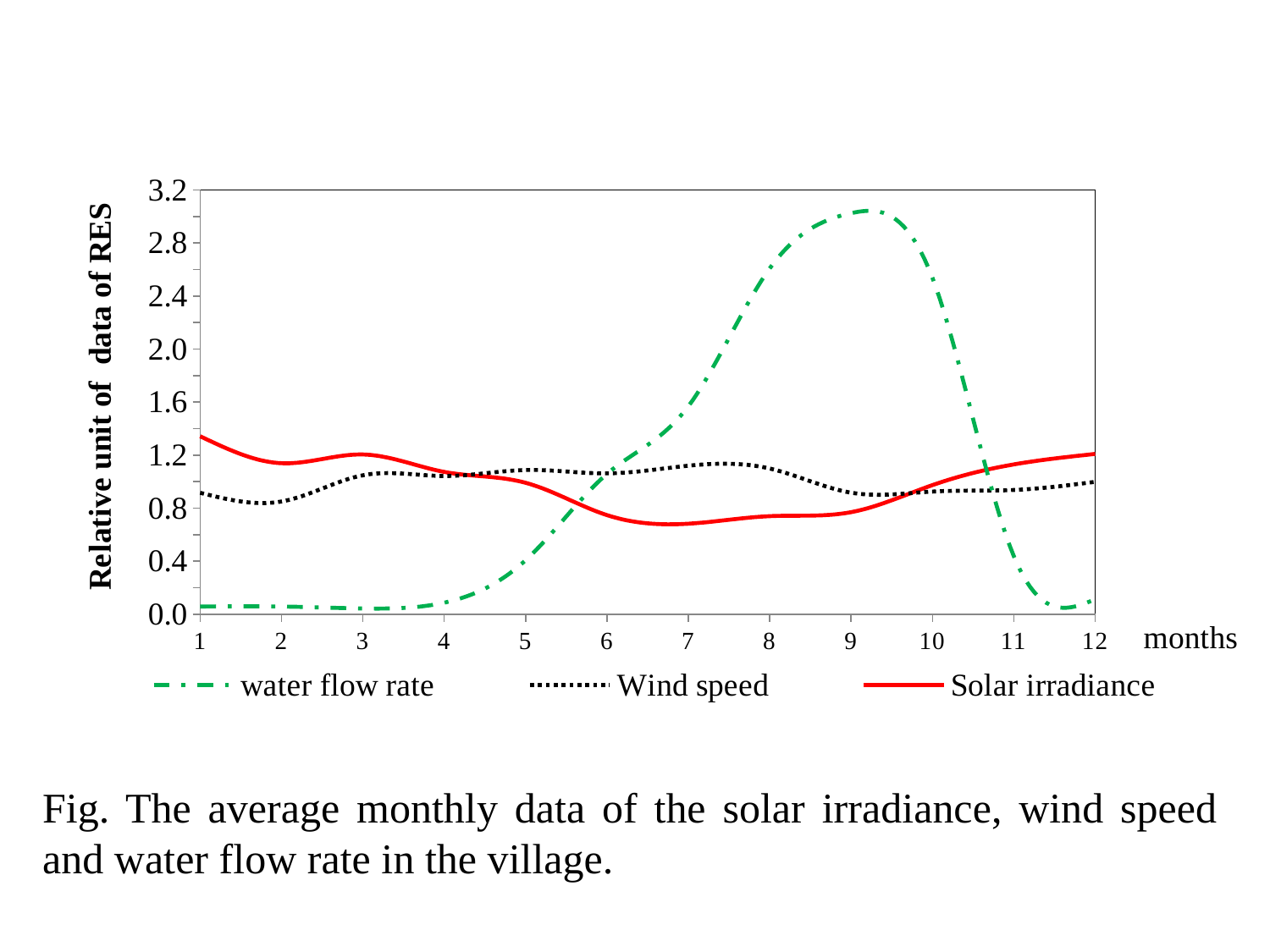
Is the value for water flow rate at month 3 greater or less than 0.4? less How many months are shown along the x axis? 12 What kind of chart is shown on the slide? line chart At month 7, which is larger: Wind speed or Solar irradiance? Wind speed Is the value for Solar irradiance at month 7 greater or less than 0.8? less In which month does the water flow rate reach its highest value? 9 Is the value for Solar irradiance at month 1 greater or less than 1.2? greater Which series reaches the highest value on the chart? water flow rate What is the label of the y axis? Relative unit of data of RES How many series does the legend list? 3 Does the water flow rate rise or fall from month 9 to month 12? fall